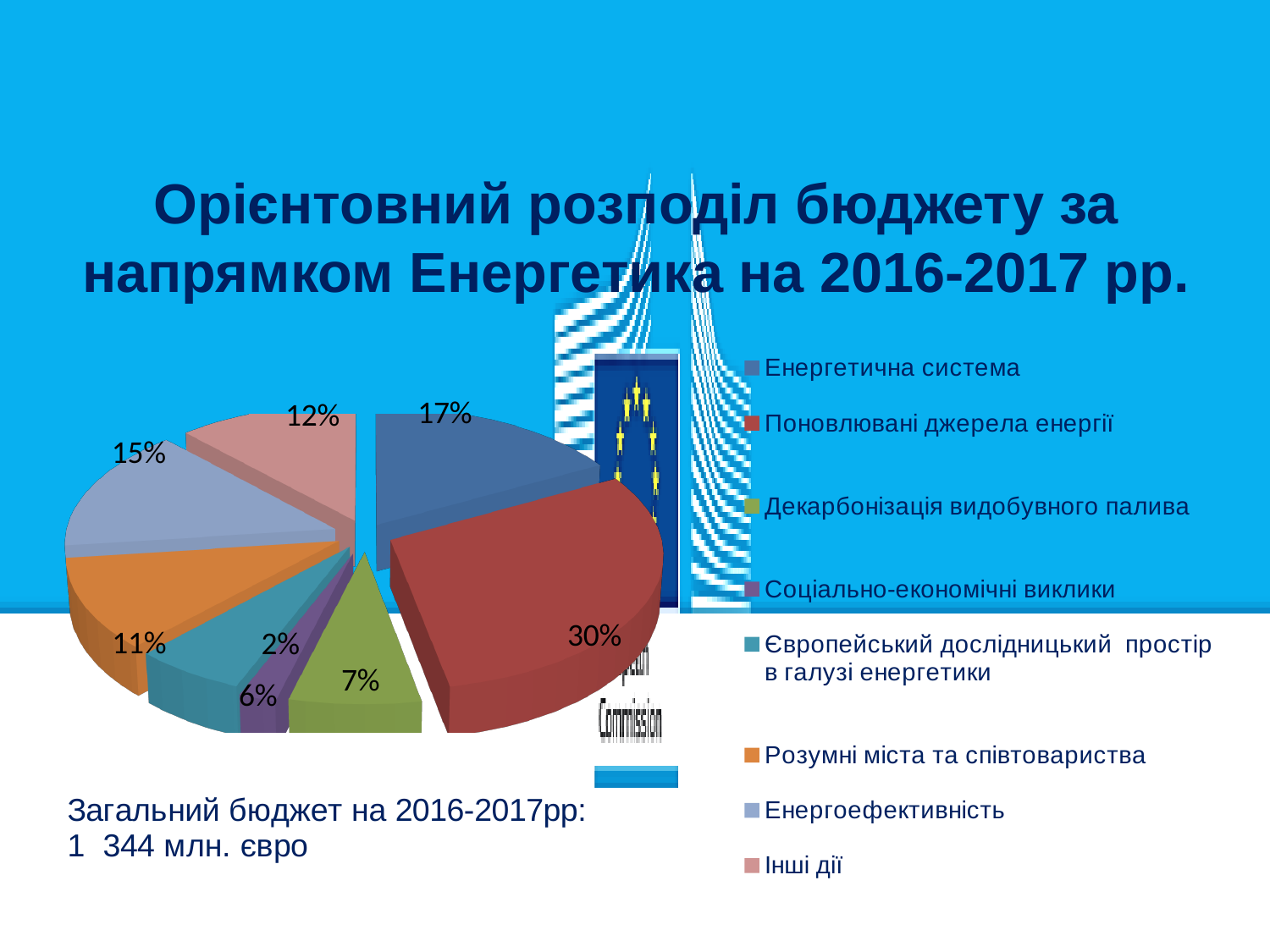
Which has a larger share: Декарбонізація видобувного палива or Інші дії? Інші дії What share of the budget goes to Розумні міста та співтовариства? 11% What type of chart is shown on the slide? pie chart What share of the budget goes to Соціально-економічні виклики? 2% What share of the budget goes to Енергоефективність? 15% What is the difference in percentage points between Поновлювані джерела енергії and Енергетична система? 13 Which category has the largest share of the budget? Поновлювані джерела енергії How many categories does the legend list? 8 Which category has the smallest share of the budget? Соціально-економічні виклики What share of the budget goes to Поновлювані джерела енергії? 30% What share of the budget goes to Енергетична система? 17% What is the title of the slide containing the chart? Орієнтовний розподіл бюджету за напрямком Енергетика на 2016-2017 рр.